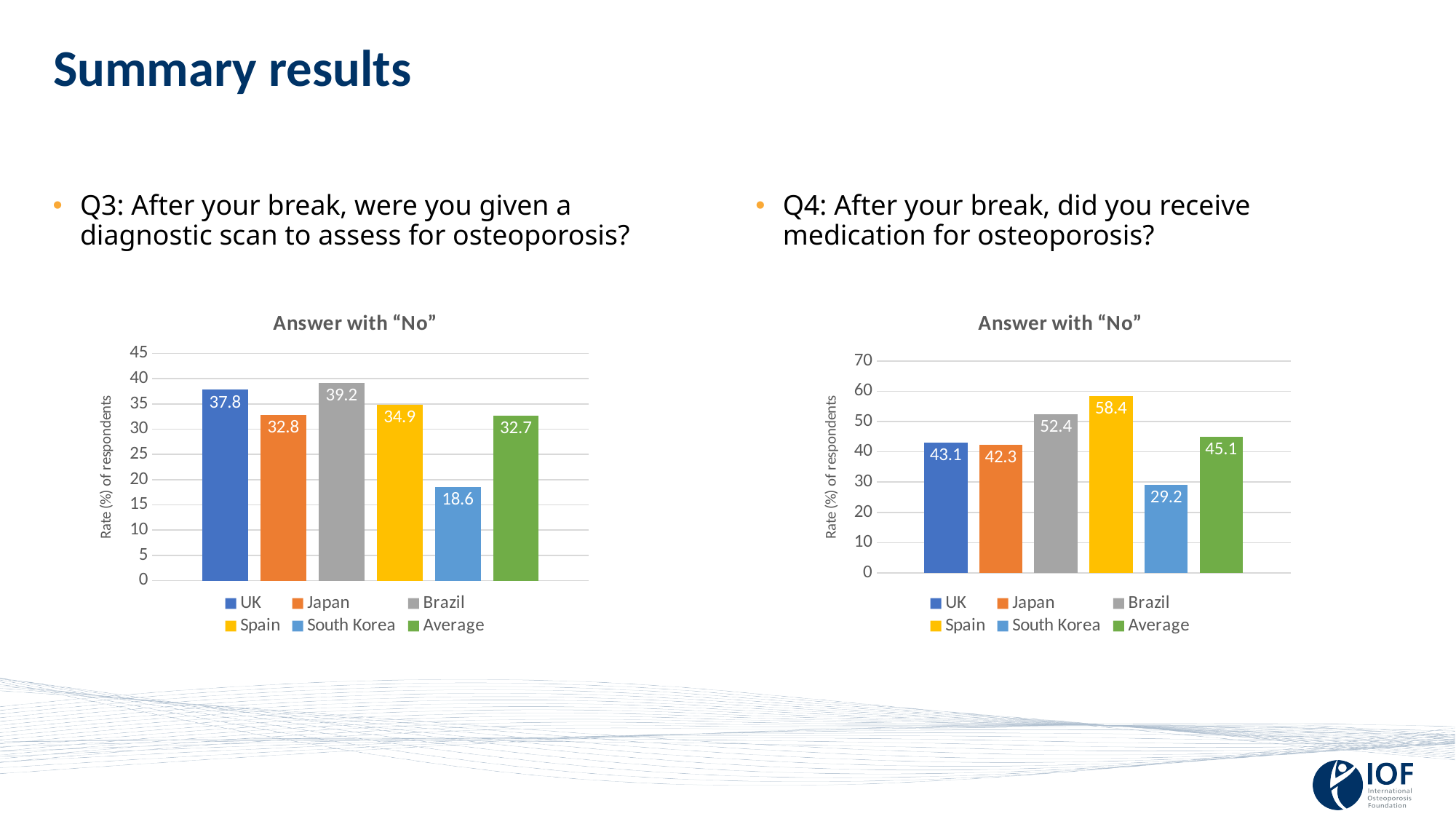
How many entries does the legend of the right chart (Q4, medication) list? 6 In the left chart (Q3, diagnostic scan), what is the Average value? 32.7 In the right chart (Q4, medication), which country has the highest rate of 'No' answers? Spain In the right chart (Q4, medication), is the value for Brazil greater or less than 50? greater In the left chart (Q3, diagnostic scan), which is larger, the value for UK or the value for Japan? UK In the right chart (Q4, medication), what is the value for South Korea? 29.2 What is the y-axis label of the right chart (Q4, medication)? Rate (%) of respondents In the left chart (Q3, diagnostic scan), which country has the lowest rate of 'No' answers? South Korea In the left chart (Q3, diagnostic scan), what is the value for Brazil? 39.2 How many bars are plotted in the left chart (Q3, diagnostic scan)? 6 In the right chart (Q4, medication), what is the difference between Spain and South Korea? 29.2 What type of chart is used for the Q3 results on the left? Bar chart